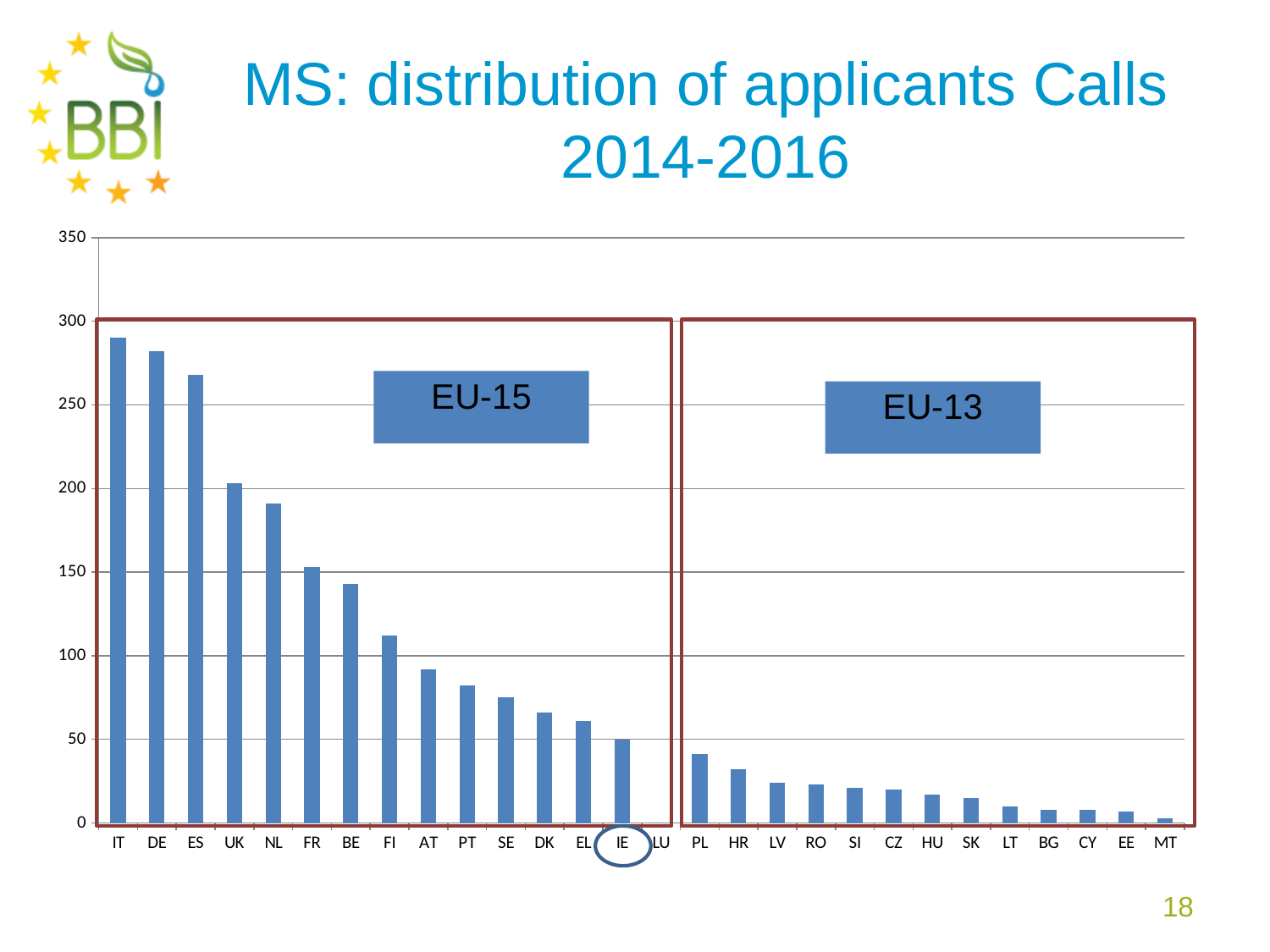
What kind of chart is shown on the slide? bar chart What are the two group labels shown in the boxes over the chart? EU-15 and EU-13 Which country has the highest number of applicants in the chart? IT Is the value for FI greater or less than 100? greater Which has a larger value, PL or HR? PL Is the value for BE greater or less than 150? less Which has a larger value, ES or UK? ES Is the value for IT greater or less than 250? greater Which country in the EU-13 group has the lowest bar? MT How many countries are shown on the x axis of the chart? 28